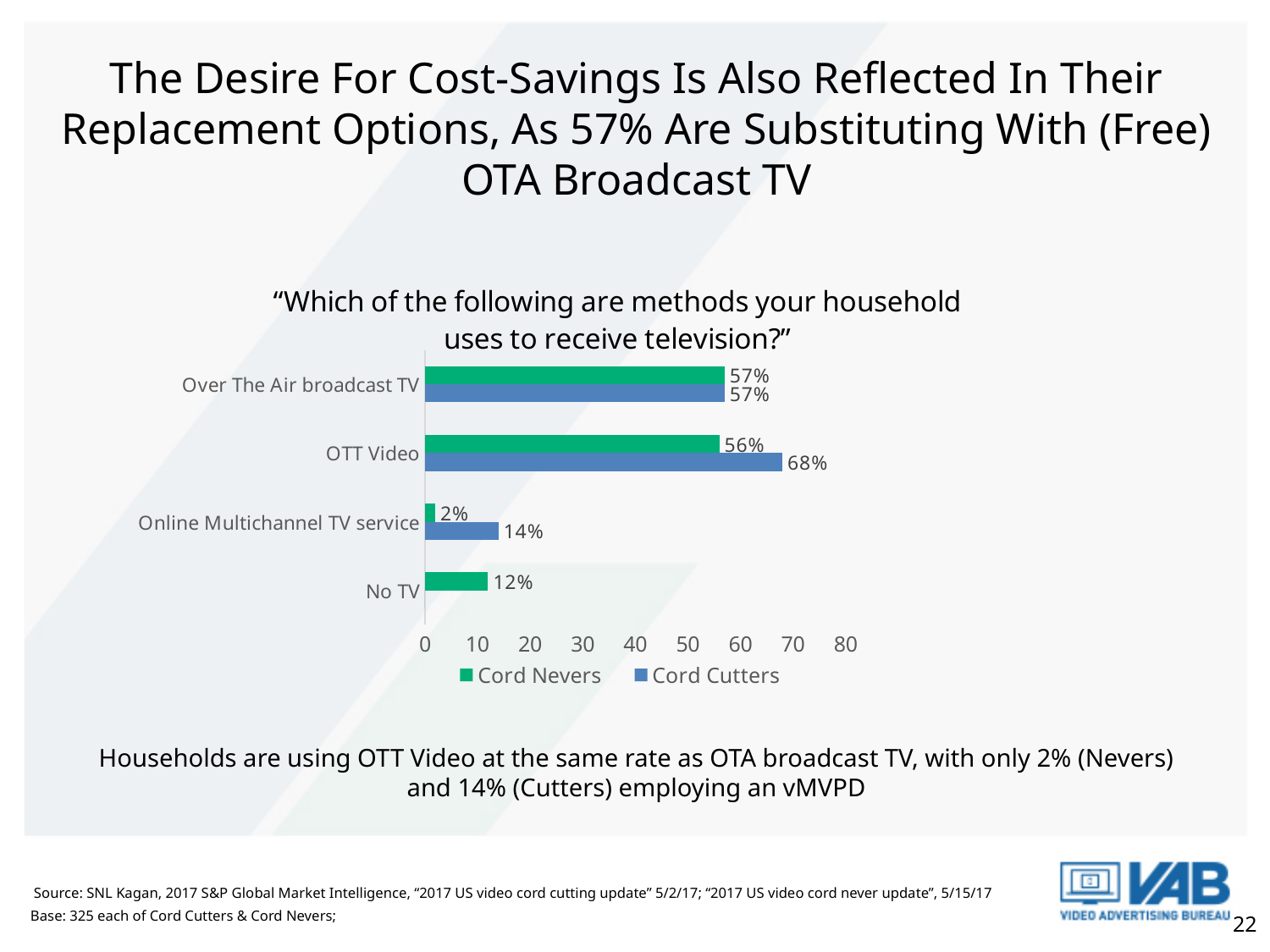
What is the difference between the Cord Cutters and Cord Nevers values for OTT Video? 12% What is the Cord Cutters value for Over The Air broadcast TV? 57% Which category has the highest Cord Cutters value? OTT Video How many categories are shown on the chart? 4 How many series does the legend list? 2 Which category has the lowest Cord Nevers value? Online Multichannel TV service For Online Multichannel TV service, which is larger: the Cord Nevers value or the Cord Cutters value? Cord Cutters What is the difference between the Cord Cutters and Cord Nevers values for Online Multichannel TV service? 12% What is the Cord Nevers value for Online Multichannel TV service? 2% What is the Cord Nevers value for No TV? 12% What kind of chart is shown on the slide? Bar chart What is the Cord Cutters value for OTT Video? 68%